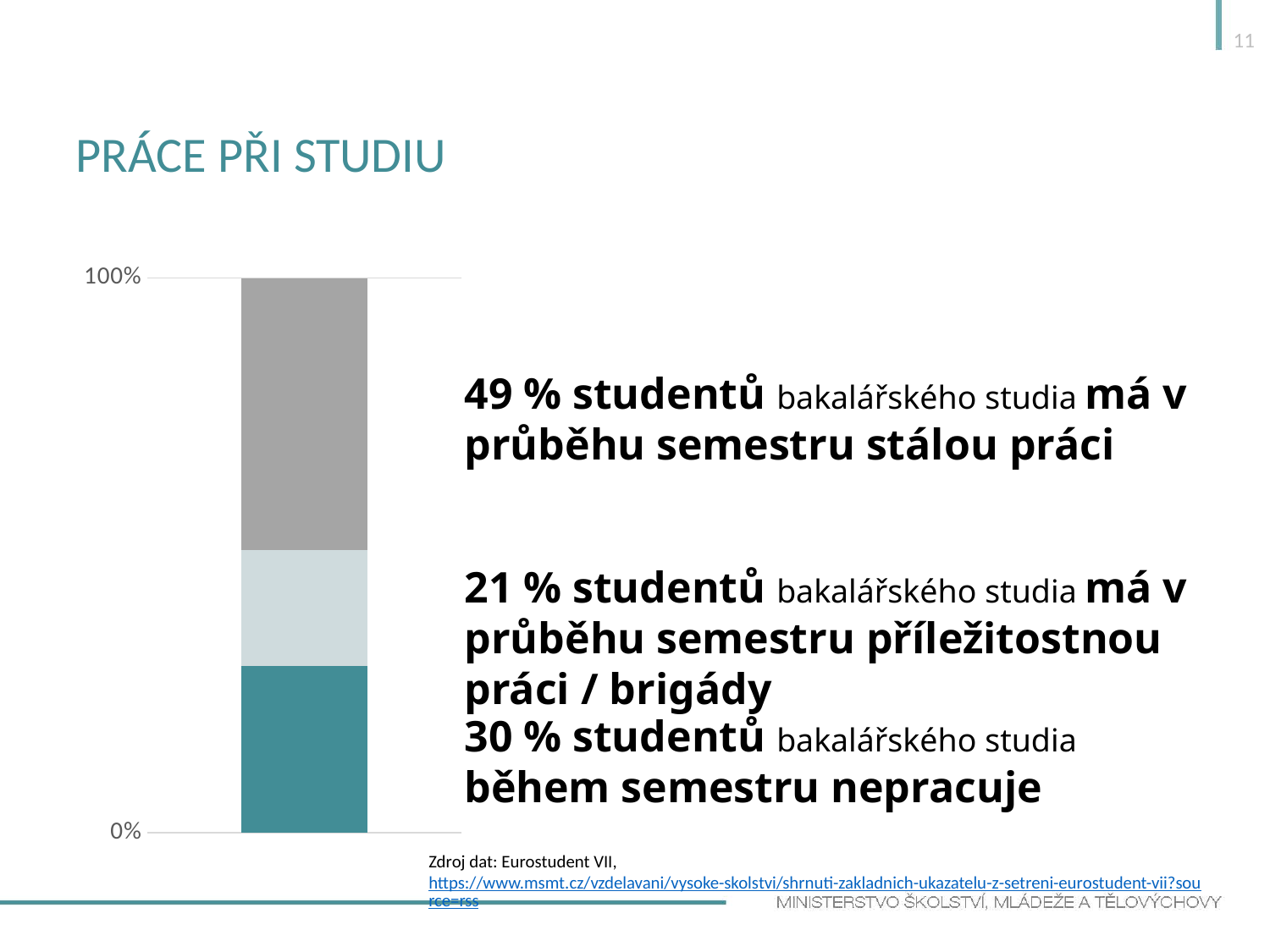
Which segment of the stacked bar is the largest: the top grey one, the middle light one, or the bottom teal one? the top grey one According to the slide, what share of bachelor students has a steady job during the semester? 49 % What is the highest value shown on the vertical axis? 100% Which segment of the stacked bar is the smallest: the top grey one, the middle light one, or the bottom teal one? the middle light one What is the lowest value shown on the vertical axis? 0% Is the bottom teal segment of the bar larger or smaller than the top grey segment? smaller What is the title of the slide containing the chart? PRÁCE PŘI STUDIU What kind of chart is shown on the slide? stacked bar chart According to the slide, what share of bachelor students has occasional work / temporary jobs during the semester? 21 % According to the slide, what share of bachelor students does not work during the semester? 30 % How many segments does the stacked bar contain? 3 How many bars are plotted in the chart? 1